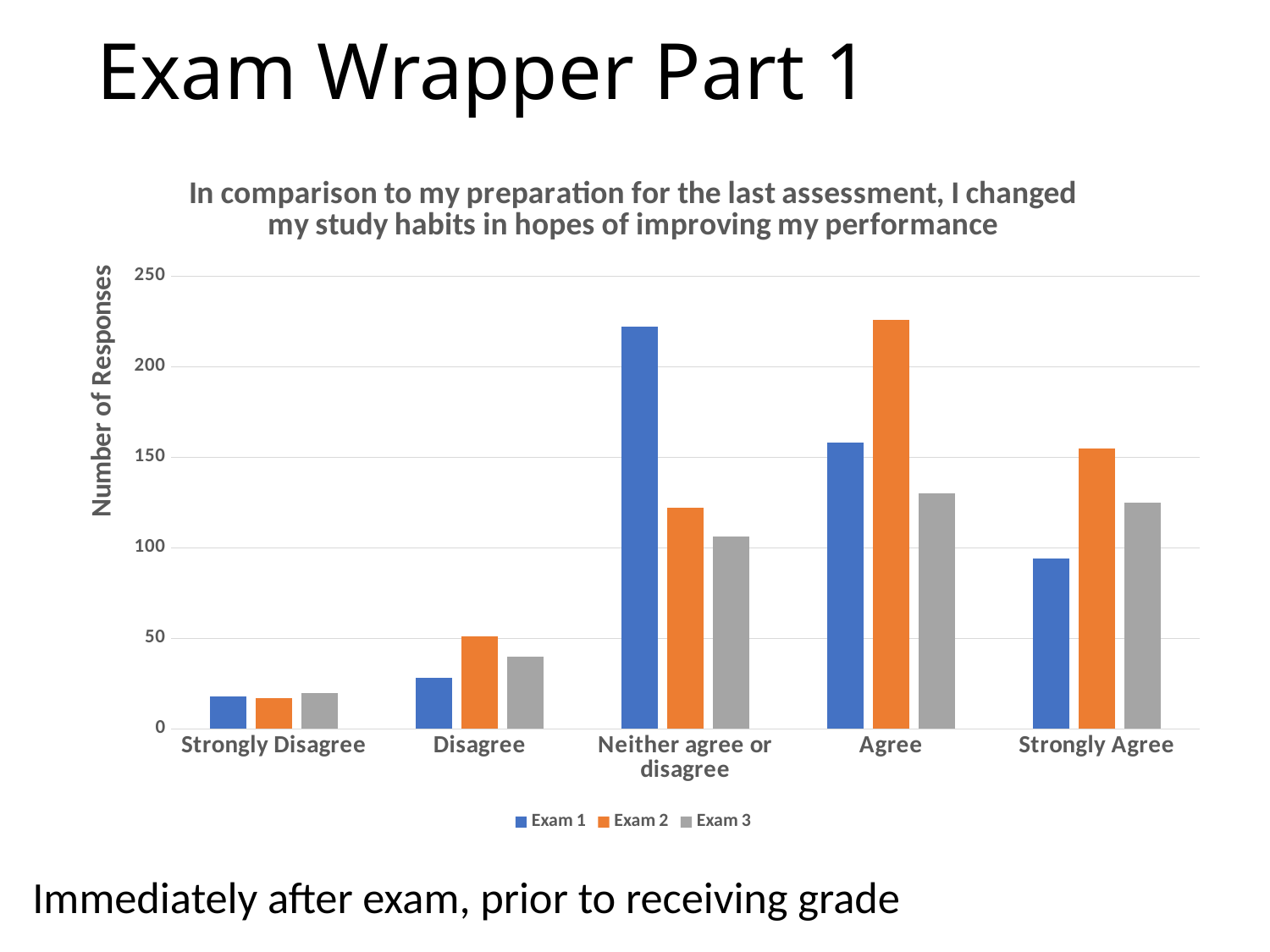
For Exam 2, which response category has the highest number of responses? Agree How many series does the legend list? 3 Which series is shown in orange in the legend? Exam 2 For Exam 2, which response category has the lowest number of responses? Strongly Disagree For Exam 1, which response category has the highest number of responses? Neither agree or disagree Is the Exam 3 value for Disagree greater or less than 50? less How many response categories are shown on the x axis? 5 What kind of chart is shown on the slide? Bar chart Is the Exam 1 value for Neither agree or disagree greater or less than 200? greater What is the label of the vertical axis? Number of Responses For the Neither agree or disagree category, which is larger: Exam 1 or Exam 3? Exam 1 For the Agree category, which is larger: Exam 1 or Exam 2? Exam 2